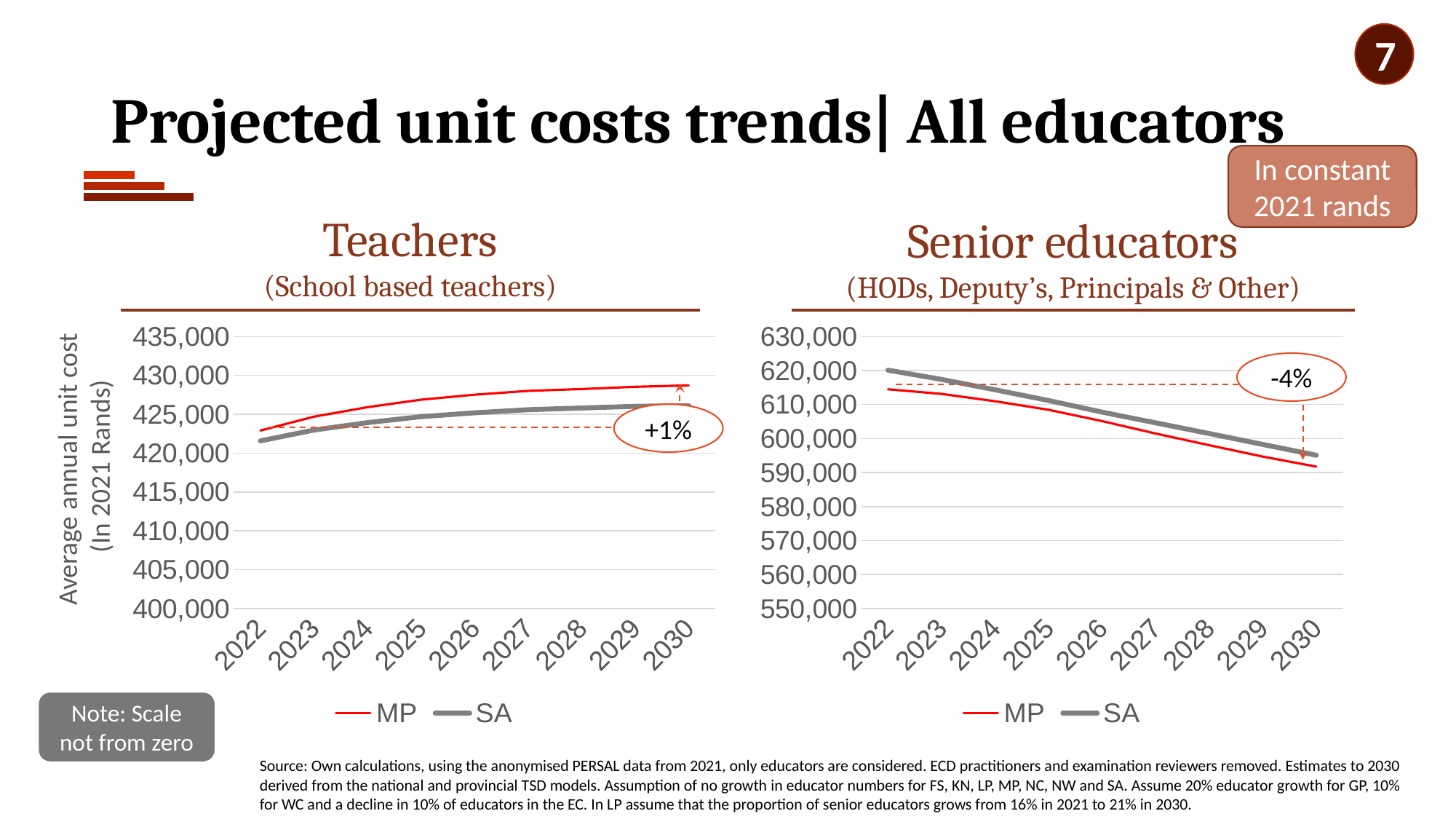
In the Senior educators chart, is the value for MP in 2022 greater or less than 610,000? greater In the Senior educators chart, which series has the higher value in 2022, MP or SA? SA What percentage change is annotated on the Senior educators chart? -4% In the Teachers chart, is the value for MP in 2030 greater or less than 425,000? greater In the Teachers chart, do the values for SA rise or fall from 2022 to 2030? Rise In the Senior educators chart, is the value for MP in 2030 greater or less than 600,000? less How many series does the legend of the Senior educators chart list? 2 How many years are shown on the x axis of the Teachers chart? 9 In the Senior educators chart, do the values for MP rise or fall from 2022 to 2030? Fall What type of chart is the Teachers chart? Line chart In the Teachers chart, which series has the higher value in 2030, MP or SA? MP